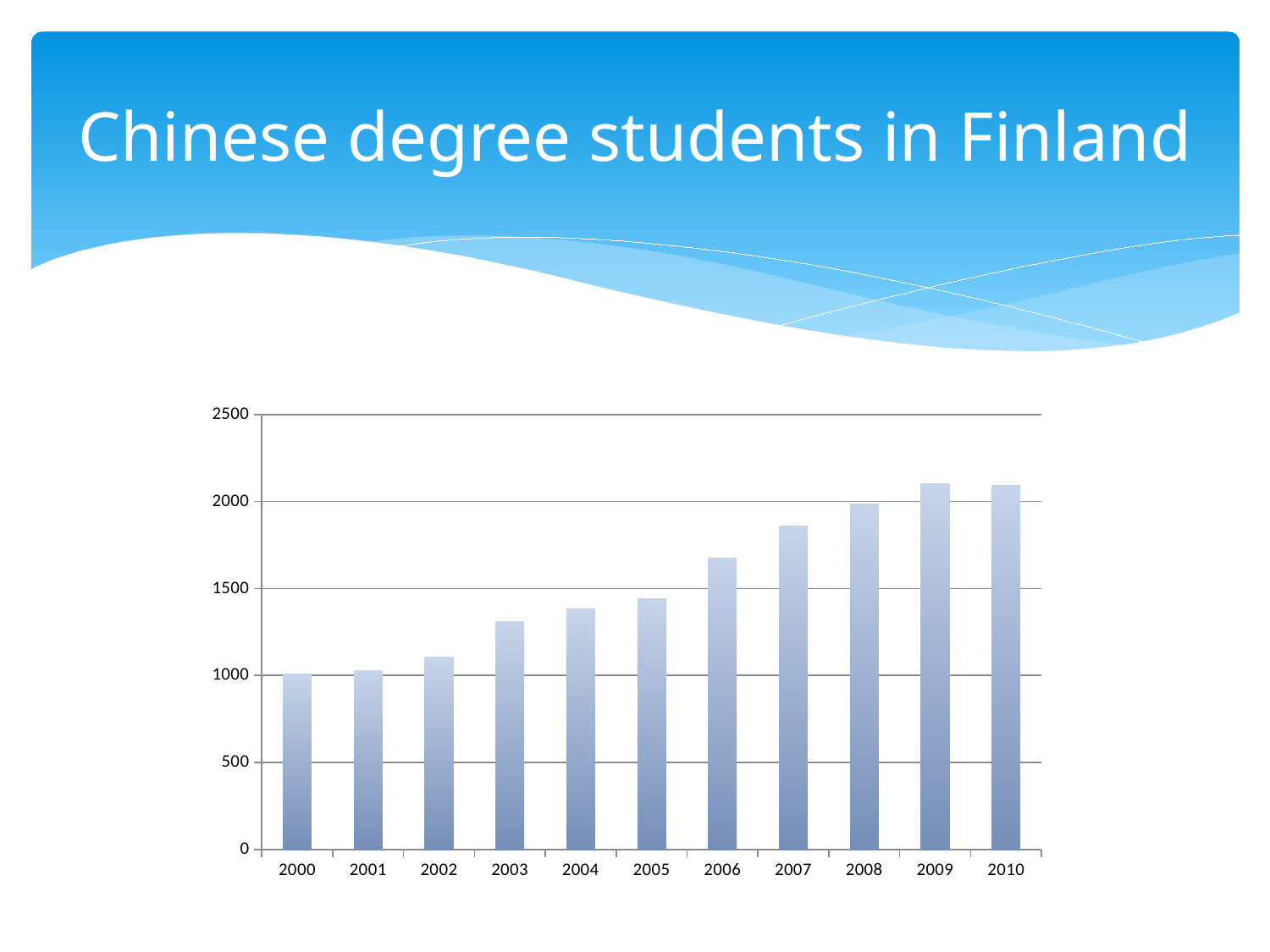
Is the value for 2002 greater or less than 1000? greater Is the value for 2005 greater or less than 1500? less What kind of chart is shown on the slide? bar chart Which year has the larger value, 2003 or 2006? 2006 Do the values generally rise or fall from 2000 to 2010? rise Is the value for 2009 greater or less than 2000? greater What is the title of the slide containing the chart? Chinese degree students in Finland Which year has the larger value, 2004 or 2007? 2007 How many years are shown on the x axis of the chart? 11